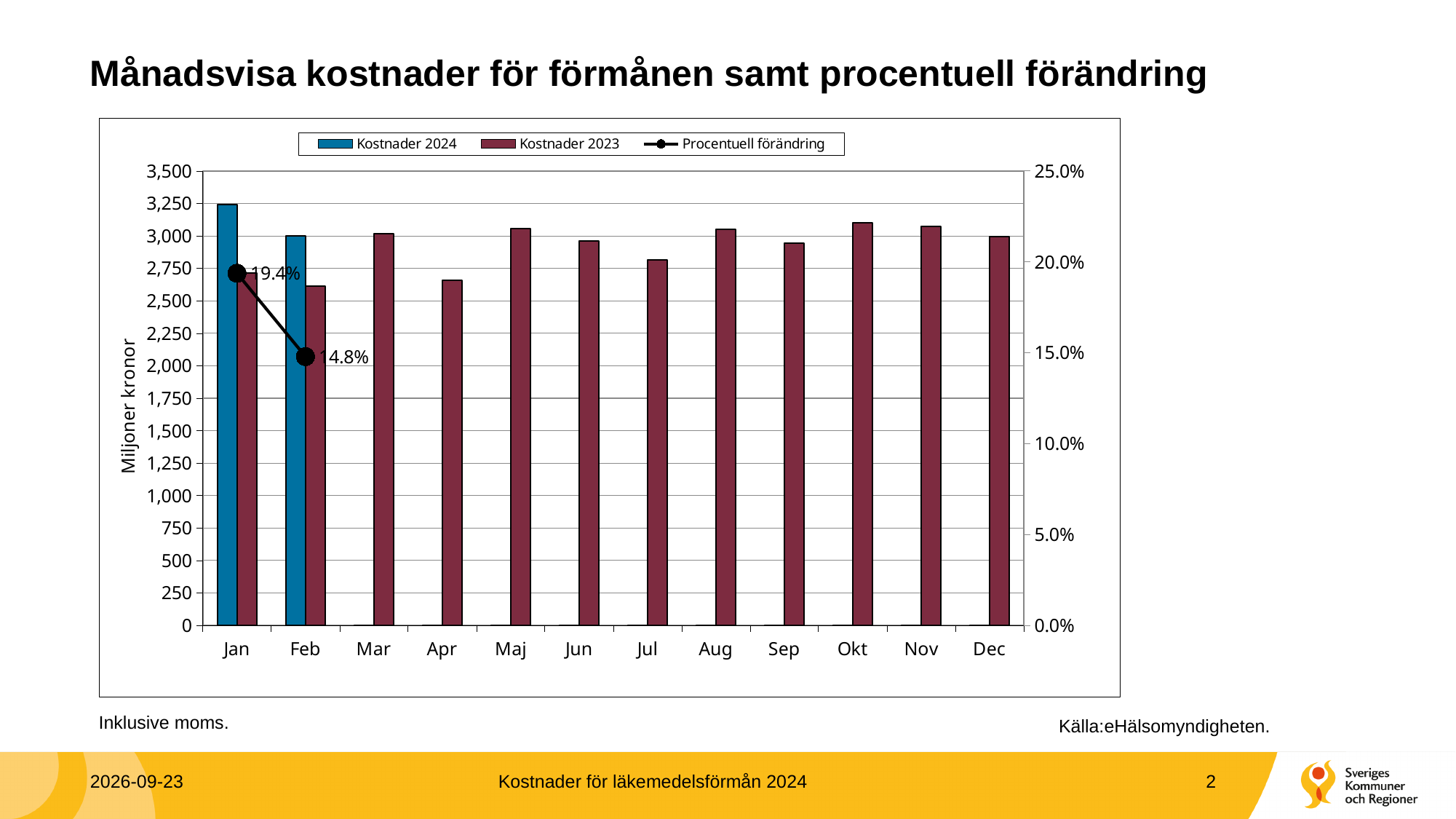
For Jan, which is larger: Kostnader 2024 or Kostnader 2023? Kostnader 2024 What is the label on the left vertical axis? Miljoner kronor What is the Procentuell förändring value shown for Feb? 14.8% What is the difference between the Procentuell förändring values for Jan and Feb? 4.6 percentage points What is the Procentuell förändring value shown for Jan? 19.4% Does the Procentuell förändring line rise or fall from Jan to Feb? fall What kind of chart is this? Bar chart with a line Is the Kostnader 2023 value for Apr greater or less than 2,750? less How many series does the legend list? 3 Is the Kostnader 2023 value for Jul greater or less than 3,000? less Is the Kostnader 2024 value for Jan greater or less than 3,000? greater How many months are shown on the x axis? 12